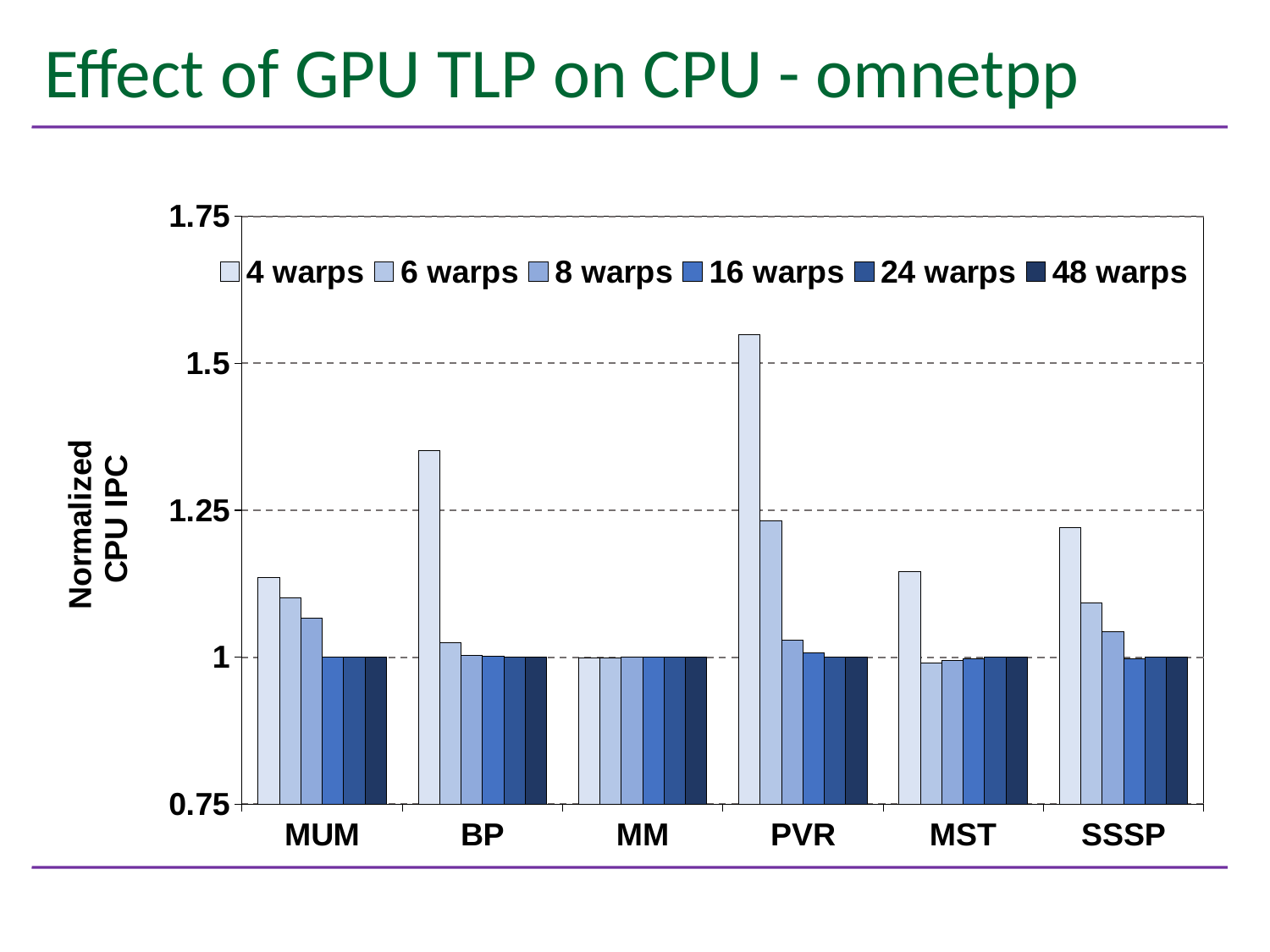
Which category has the lowest 4 warps bar? MM Is the 4 warps value for MST greater or less than 1.25? less Is the 4 warps value for BP greater or less than 1.25? greater What is the label on the y axis? Normalized CPU IPC Is the 4 warps value for PVR greater or less than 1.5? greater How many categories are shown on the x axis? 6 Which category has the highest 4 warps bar? PVR Which is larger, the 4 warps value for BP or the 4 warps value for SSSP? BP What kind of chart is shown on the slide? bar chart For PVR, do the values rise or fall as the number of warps increases from 4 to 48? fall How many series does the legend list? 6